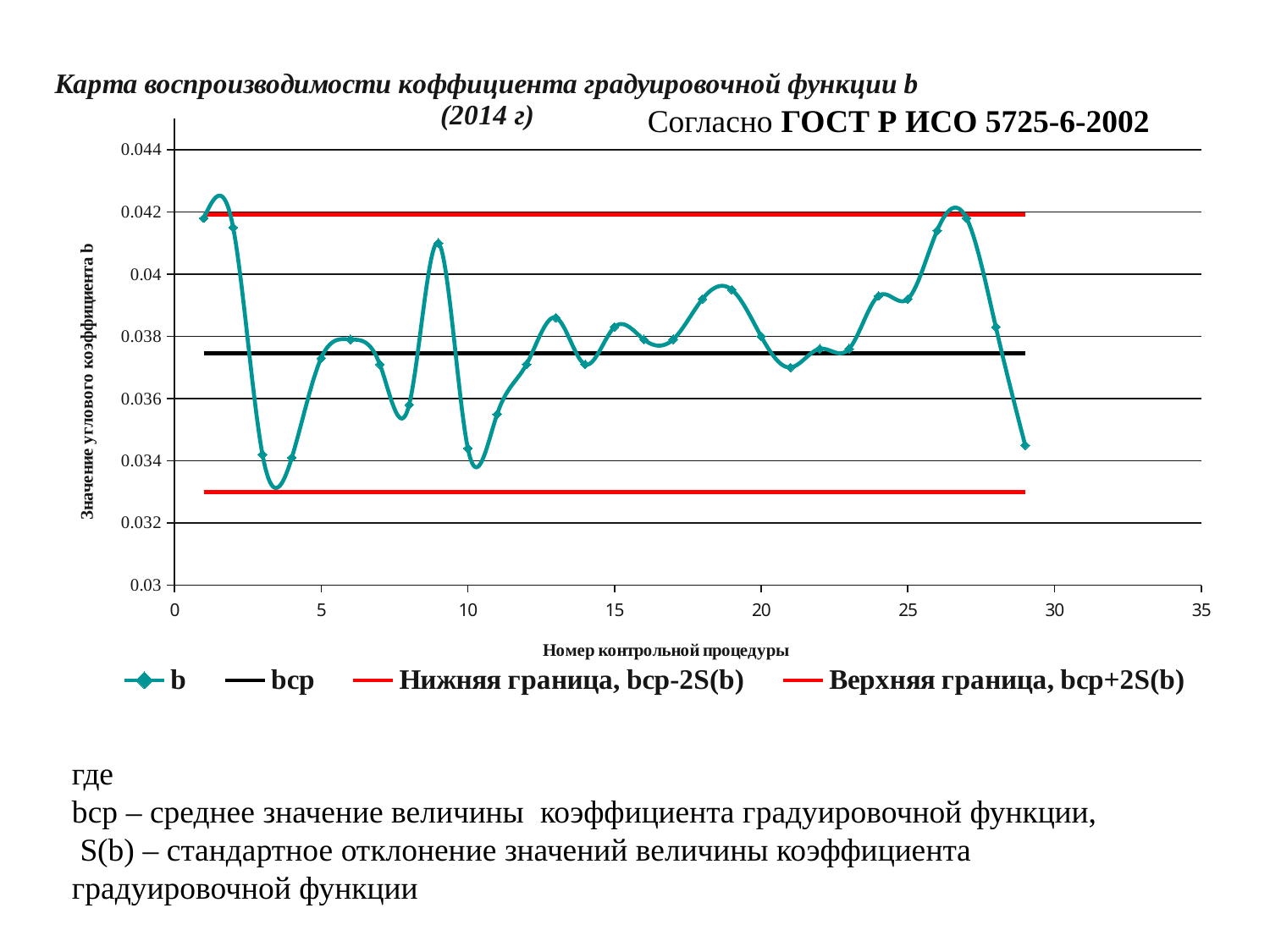
Is the value of b for control procedure 9 greater or less than 0.04? greater How many series does the legend list? 4 What is the label of the x axis? Номер контрольной процедуры Which has the larger value of b: control procedure 9 or control procedure 10? control procedure 9 Is the value of b for control procedure 29 greater or less than 0.036? less Is the value of b for control procedure 1 greater or less than 0.04? greater Which has the larger value of b: control procedure 1 or control procedure 3? control procedure 1 What kind of chart is shown on the slide? line chart What is the title of the chart? Карта воспроизводимости коффициента градуировочной функции b (2014 г)